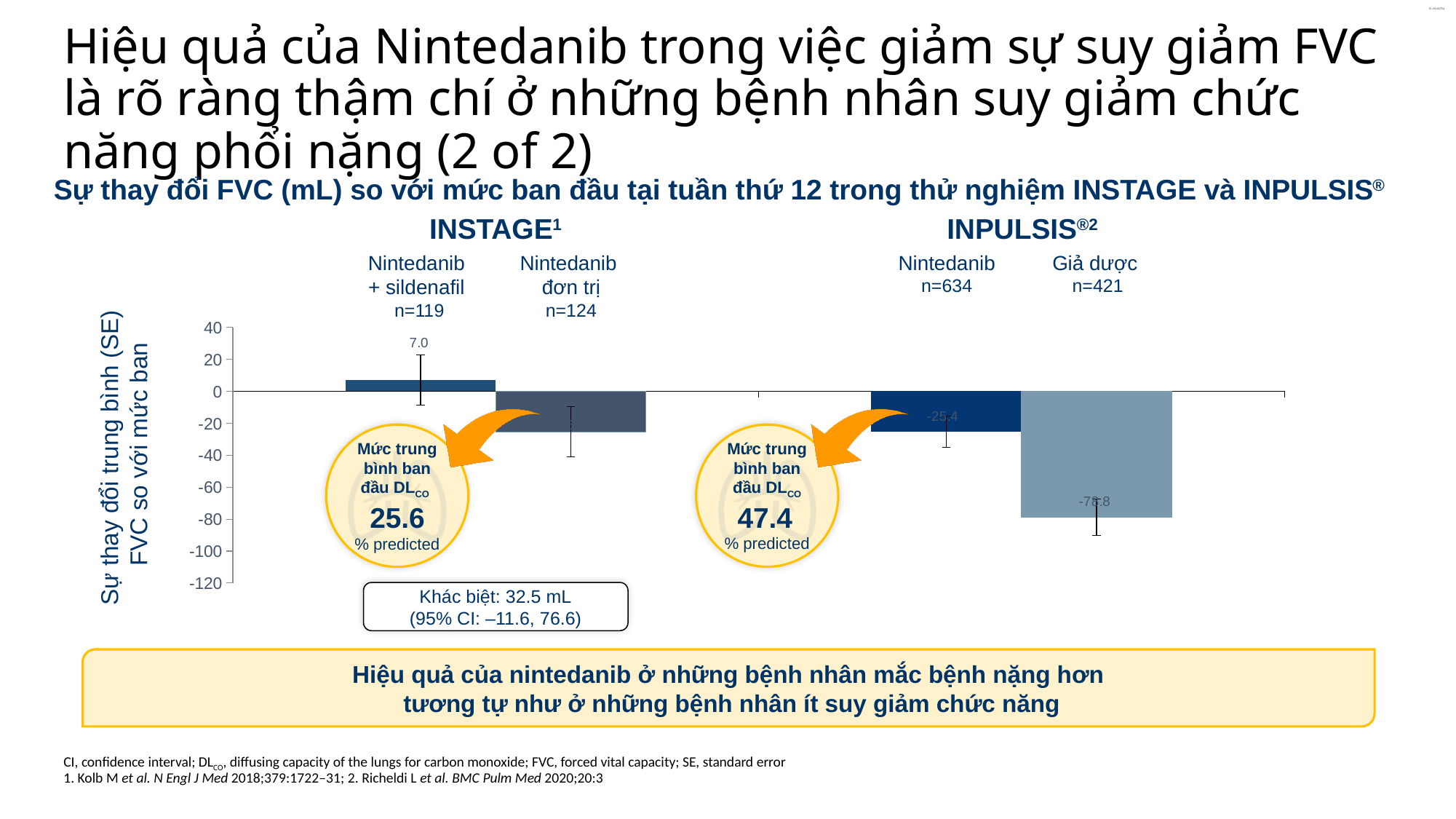
Which group has the highest mean change in FVC? Nintedanib + sildenafil (INSTAGE) What kind of chart is shown on the slide? bar chart What is the mean change in FVC for the Nintedanib + sildenafil group in INSTAGE? 7.0 What is the mean change in FVC for the Giả dược (placebo) group in INPULSIS? -78.8 Is the value for Nintedanib đơn trị in INSTAGE greater or less than 0? less Is the value for Giả dược in INPULSIS greater or less than -60? less Which group has the lowest (most negative) mean change in FVC? Giả dược (INPULSIS) What is the mean change in FVC for the Nintedanib group (n=634) in INPULSIS? -25.4 What is the sample size (n) of the Giả dược group in INPULSIS? n=421 How many bars are plotted in the chart? 4 What is the difference between the Nintedanib and Giả dược values in INPULSIS? 53.4 Which is larger: the FVC change for Nintedanib + sildenafil or for Nintedanib đơn trị in INSTAGE? Nintedanib + sildenafil